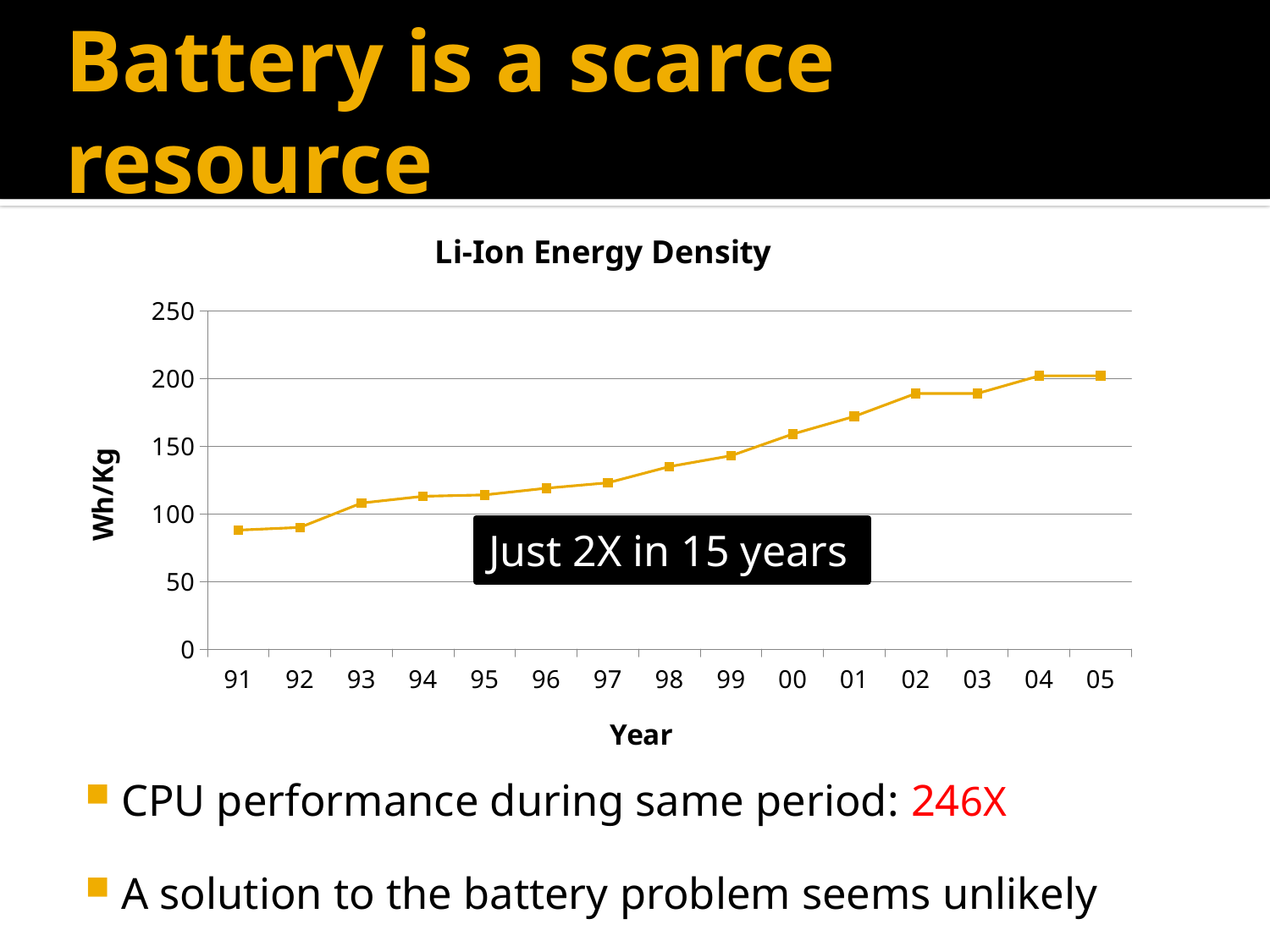
What kind of chart is shown on the slide? line chart Do the values rise or fall from 91 to 05? rise Which has the larger value, 96 or 02? 02 What is the label of the y axis? Wh/Kg Is the value for 00 greater or less than 150? greater What is the title of the chart? Li-Ion Energy Density How many years are plotted on the x axis? 15 Is the value for 91 greater or less than 100? less Is the value for 98 greater or less than 150? less Which has the larger value, 95 or 00? 00